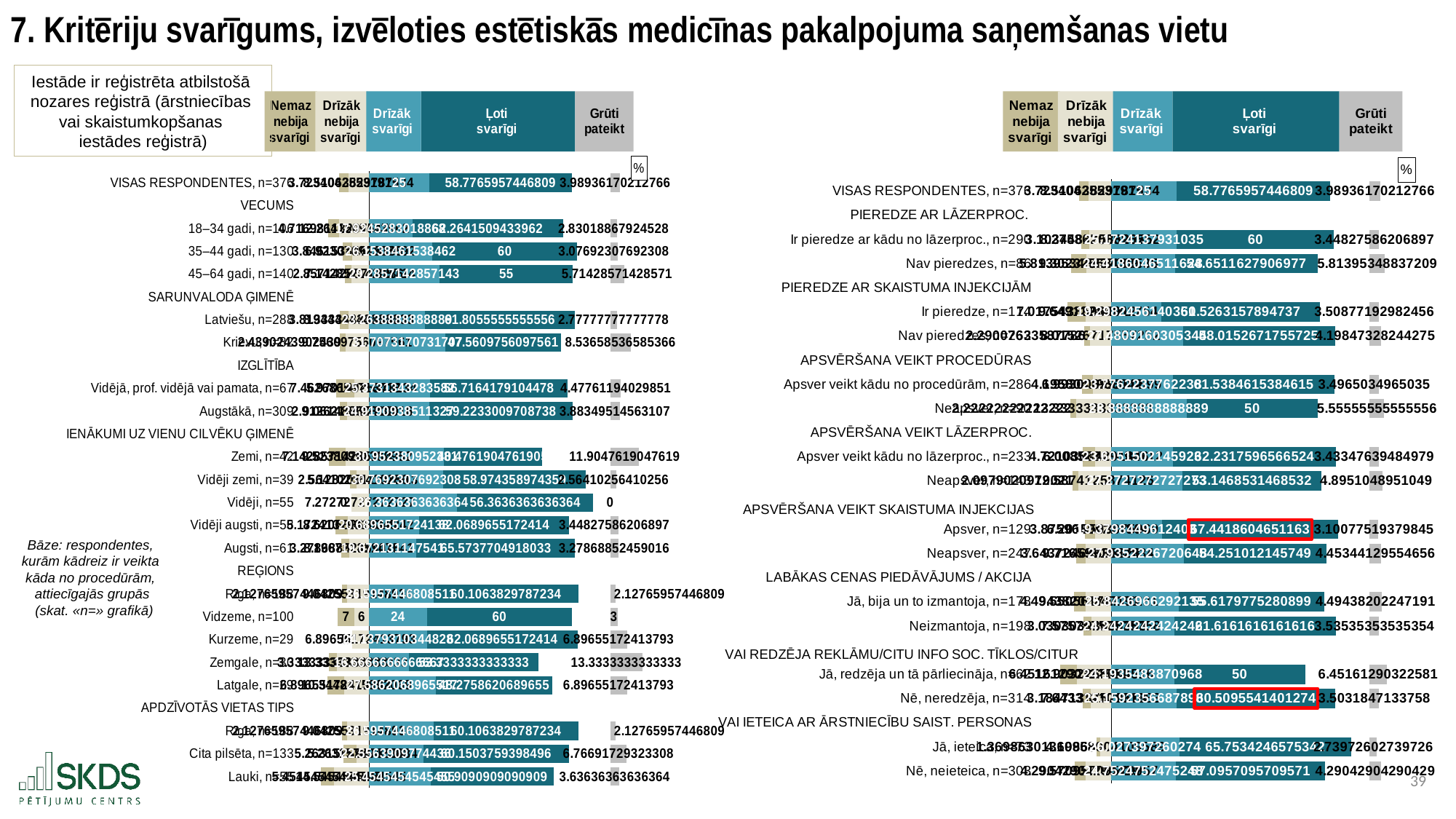
On the left chart, what is the 'Grūti pateikt' value for Zemgale, n=30? 13.3333333333333 On the left chart, what is the 'Drīzāk svarīgi' value for Vidzeme, n=100? 24 On the right chart, what is the 'Ļoti svarīgi' value for Apsver, n=129 (under 'Apsvēršana veikt skaistuma injekcijas')? 67.4418604651163 On the left chart, what is the 'Nemaz nebija svarīgi' value for Vidzeme, n=100? 7 How many series does the legend of the left chart list? 5 On the right chart, what is the 'Grūti pateikt' value for Jā, redzēja un tā pārliecināja, n=62? 6.45161290322581 On the left chart, what is the 'Ļoti svarīgi' value for Vidzeme, n=100? 60 On the right chart, what is the 'Ļoti svarīgi' value for Nē, neredzēja, n=314? 60.5095541401274 On the left chart, what is the 'Ļoti svarīgi' value for 45–64 gadi, n=140? 55 What kind of chart is the right chart? Stacked bar chart On the right chart, which is larger: the 'Ļoti svarīgi' value for Ir pieredze ar kādu no lāzerproc., n=290 or for Jā, redzēja un tā pārliecināja, n=62? Ir pieredze ar kādu no lāzerproc., n=290 On the left chart, what is the 'Grūti pateikt' value for Vidēji, n=55? 0